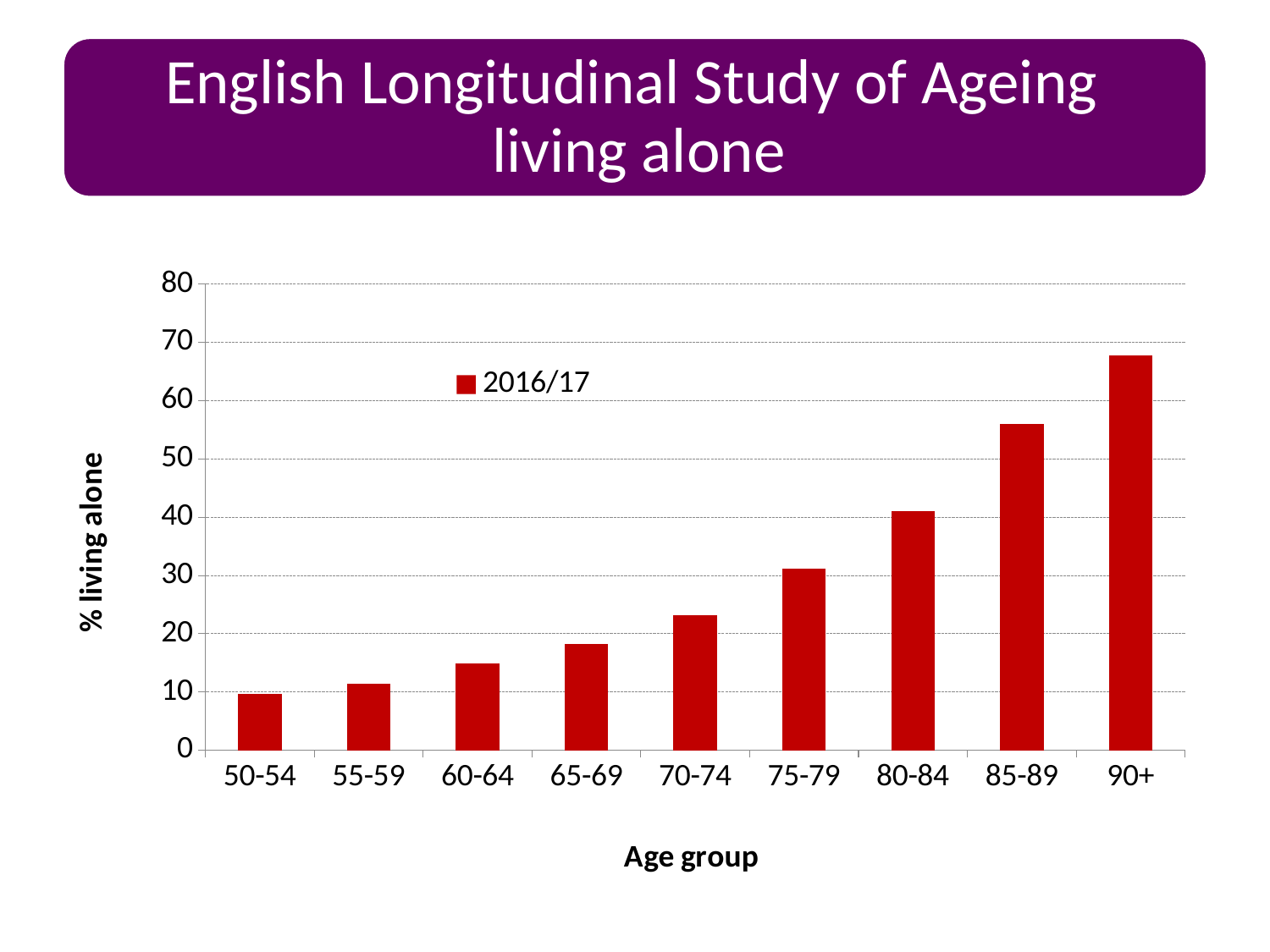
How many age groups are shown on the x axis? 9 What series name is shown in the legend? 2016/17 Is the value for 85-89 greater or less than 50? greater Is the value for 90+ greater or less than 60? greater Do the values rise or fall as age group increases along the x axis? rise Which age group has the lowest percentage living alone? 50-54 Is the value for 80-84 greater or less than 50? less Which age group has a larger percentage living alone, 75-79 or 85-89? 85-89 How many series does the legend list? 1 What kind of chart is shown on the slide? bar chart Which age group has the highest percentage living alone? 90+